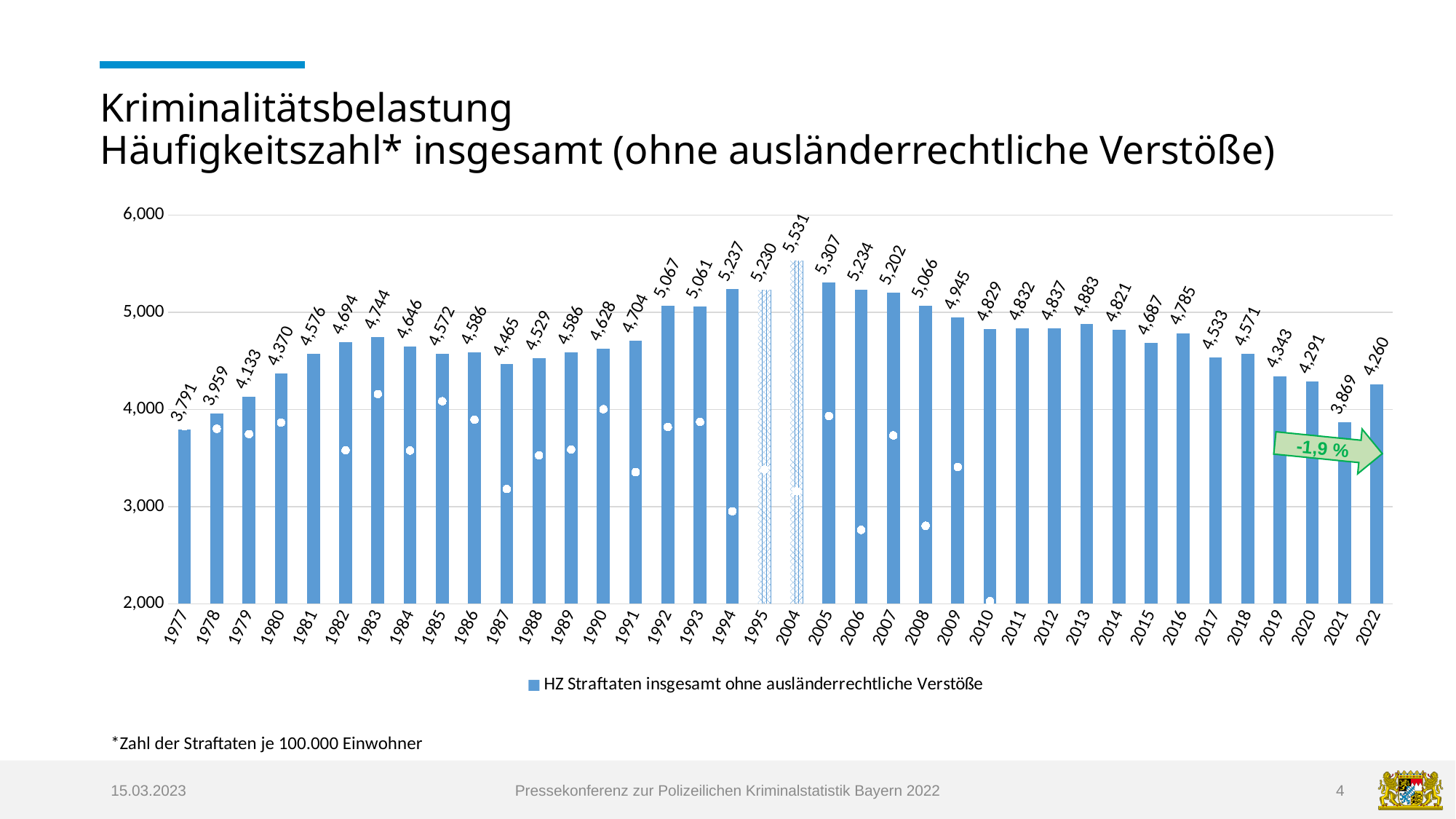
Which year has the lowest value? 1977 What percentage change is shown in the green arrow annotation? -1,9 % Which year has the highest value? 2004 Which is larger, the value for 1994 or the value for 1995? 1994 What is the value for 2004? 5,531 What is the difference between the values for 2022 and 2021? 391 What is the difference between the values for 2004 and 2005? 224 How many series does the legend list? 1 What is the value for 1977? 3,791 How many years are shown on the x axis? 38 What is the value for 2022? 4,260 What type of chart is shown on the slide? bar chart